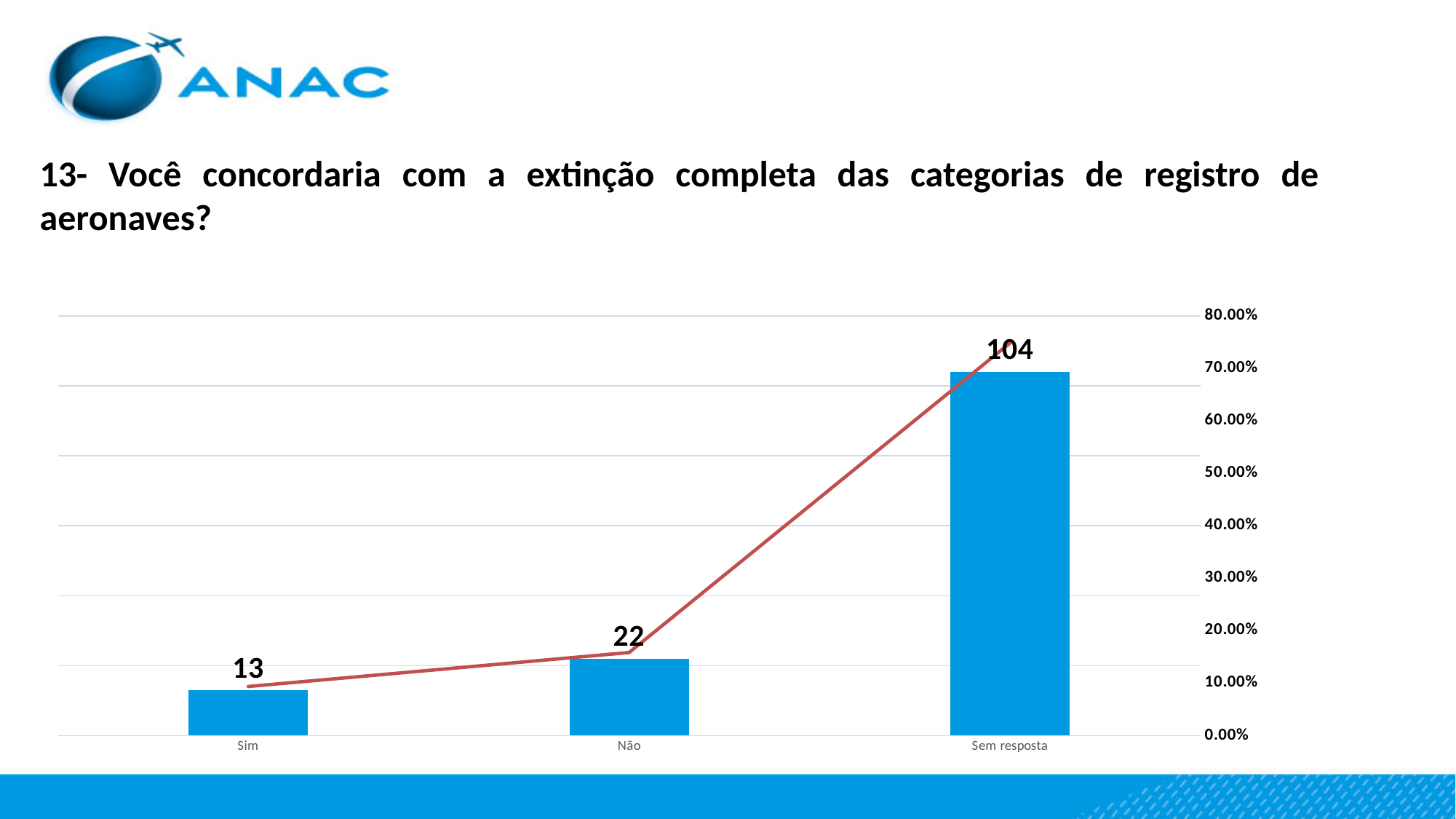
What is the difference between the values for "Não" and "Sim"? 9 What is the value shown for "Sim"? 13 What is the value shown for "Sem resposta"? 104 Is the bar for "Sem resposta" greater or less than 60.00% on the right-hand axis? greater How many categories are shown on the x axis? 3 Do the values rise or fall from "Sim" to "Sem resposta" along the x axis? Rise Which is larger, the value for "Não" or the value for "Sim"? Não What kind of chart is shown on the slide? Bar chart with a line overlay What is the value shown for "Não"? 22 What is the difference between the values for "Sem resposta" and "Não"? 82 Which category has the lowest value? Sim Which category has the highest value? Sem resposta